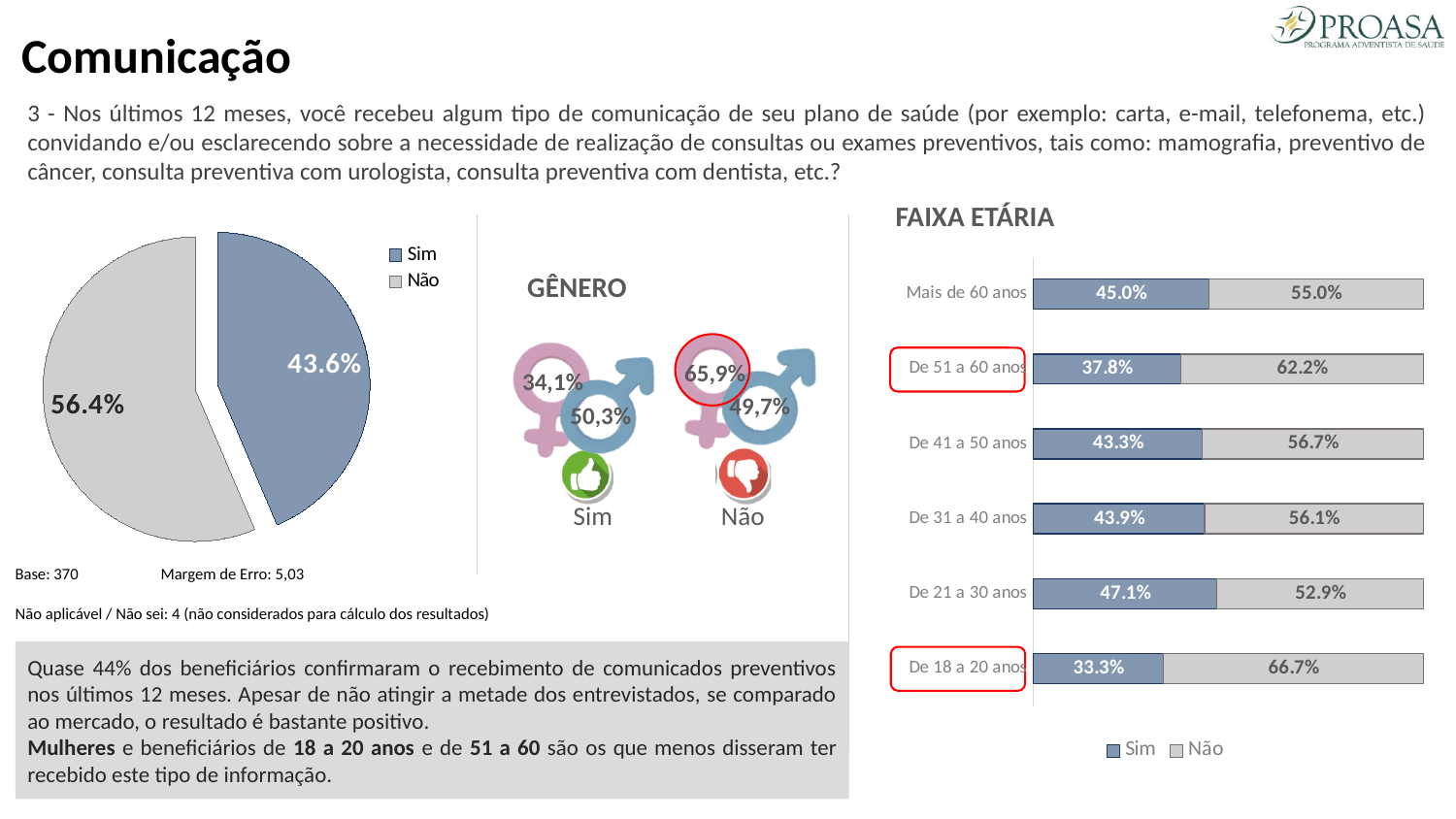
In the "FAIXA ETÁRIA" chart, what is the "Sim" value for "De 18 a 20 anos"? 33.3% In the pie chart on the left, what share of respondents answered "Não"? 56.4% What type of chart is the "FAIXA ETÁRIA" chart on the right? Bar chart In the pie chart on the left, what share of respondents answered "Sim"? 43.6% In the "FAIXA ETÁRIA" chart, what is the "Não" value for "De 51 a 60 anos"? 62.2% In the "FAIXA ETÁRIA" chart, what is the total of the "Sim" and "Não" segments for "De 41 a 50 anos"? 100.0% How many entries does the legend of the pie chart on the left list? 2 In the "FAIXA ETÁRIA" chart, which age group has the lowest "Sim" value? De 18 a 20 anos How many age groups are shown in the "FAIXA ETÁRIA" chart? 6 In the pie chart on the left, which slice is larger, "Sim" or "Não"? Não In the "FAIXA ETÁRIA" chart, what is the difference between the "Não" and "Sim" values for "Mais de 60 anos"? 10.0% In the "FAIXA ETÁRIA" chart, which age group has the highest "Sim" value? De 21 a 30 anos